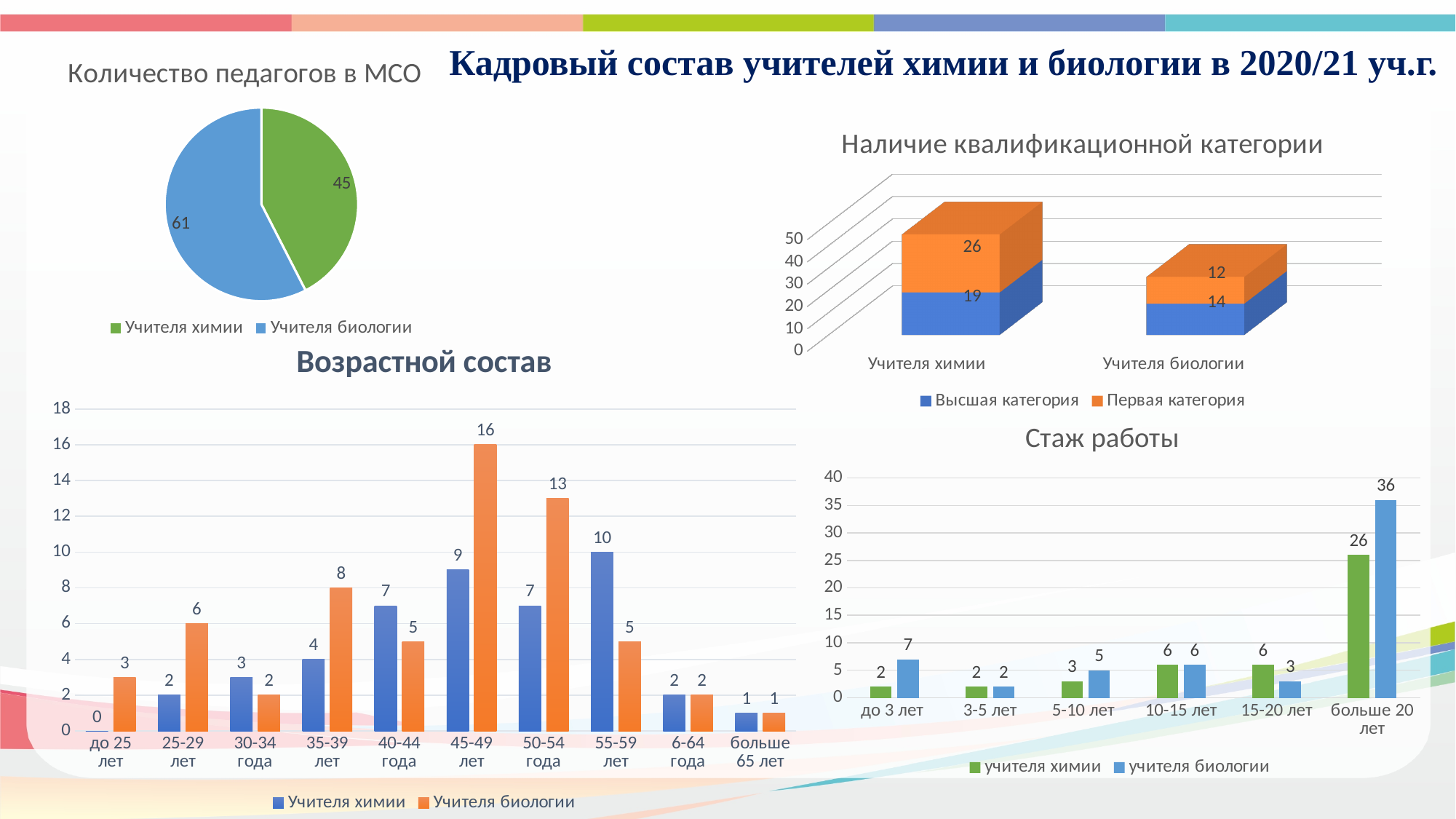
In the chart 'Наличие квалификационной категории', how many series does the legend list? 2 What type of chart is 'Количество педагогов в МСО'? Pie chart In the chart 'Возрастной состав', how many age categories are shown on the x axis? 10 In the chart 'Возрастной состав', what is the difference between 'Учителя биологии' and 'Учителя химии' in the '50-54 года' group? 6 In the chart 'Наличие квалификационной категории', what is the total of the stacked bar for 'Учителя биологии'? 26 In the chart 'Наличие квалификационной категории', what is the value of 'Первая категория' for 'Учителя химии'? 26 In the pie chart 'Количество педагогов в МСО', what is the value for 'Учителя биологии'? 61 In the pie chart 'Количество педагогов в МСО', what is the total of the two slices? 106 In the chart 'Возрастной состав', which age group has the highest value for 'Учителя химии'? 55-59 лет In the chart 'Стаж работы', what is the value for 'учителя биологии' in the 'больше 20 лет' category? 36 In the chart 'Стаж работы', which is larger in the '15-20 лет' category: 'учителя химии' or 'учителя биологии'? учителя химии In the chart 'Возрастной состав', what is the value for 'Учителя биологии' in the '45-49 лет' group? 16